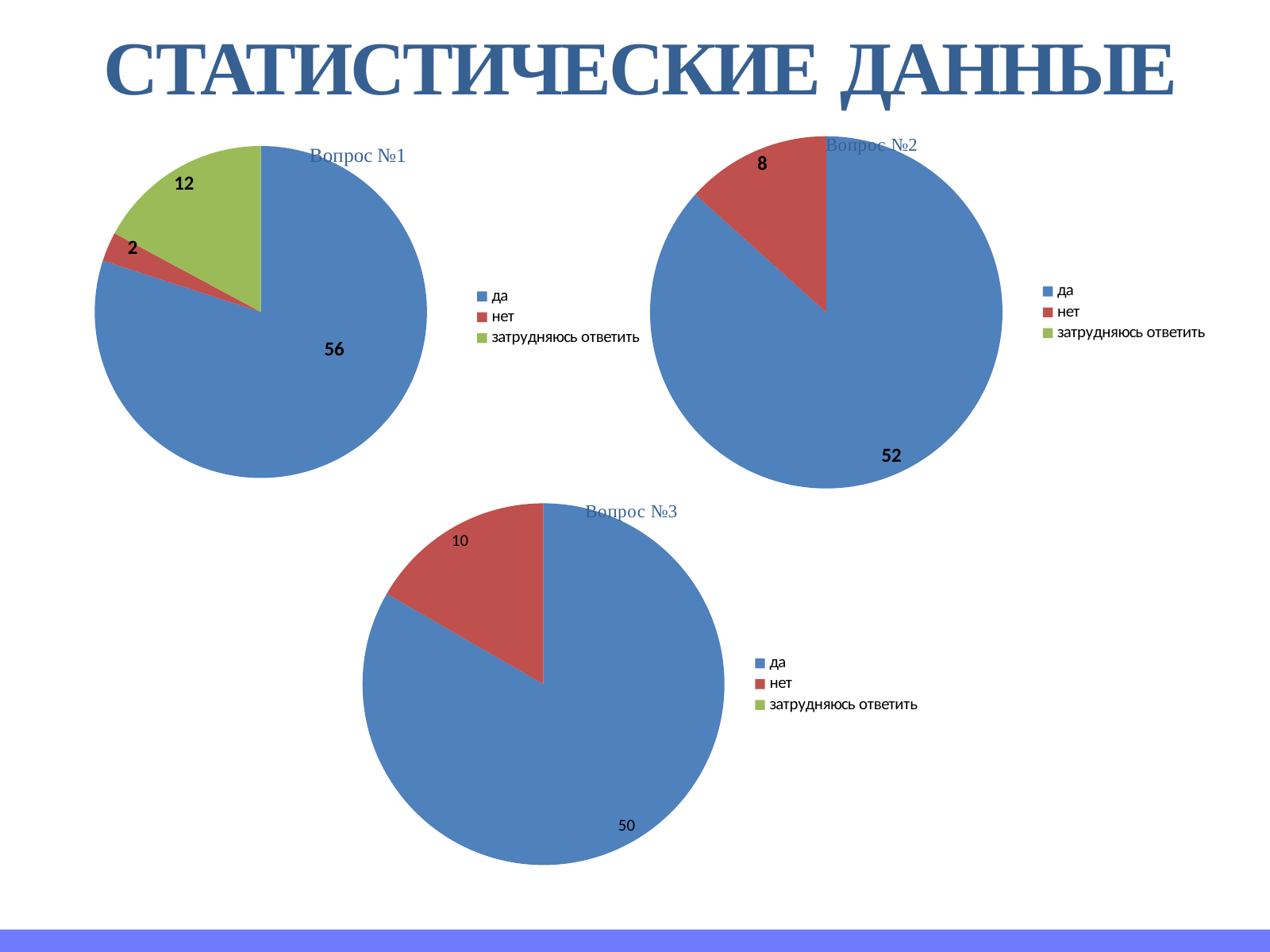
How many entries does the legend of the 'Вопрос №2' chart list? 3 In the 'Вопрос №1' pie chart, which category has the smallest slice? нет In the 'Вопрос №1' pie chart, what share of the total does 'да' represent? 80% In the 'Вопрос №1' pie chart, what is the difference between the values for 'да' and 'затрудняюсь ответить'? 44 In the 'Вопрос №3' pie chart, what is the difference between the values for 'да' and 'нет'? 40 In the 'Вопрос №2' pie chart, which category has the largest slice? да Which is larger: 'нет' in the 'Вопрос №2' chart or 'нет' in the 'Вопрос №3' chart? 'нет' in Вопрос №3 In the 'Вопрос №2' pie chart, what is the value for 'нет'? 8 In the 'Вопрос №1' pie chart, what is the value for 'да'? 56 What type of chart is 'Вопрос №3'? pie chart In the 'Вопрос №3' pie chart, what is the value for 'да'? 50 In the 'Вопрос №1' pie chart, what is the value for 'затрудняюсь ответить'? 12